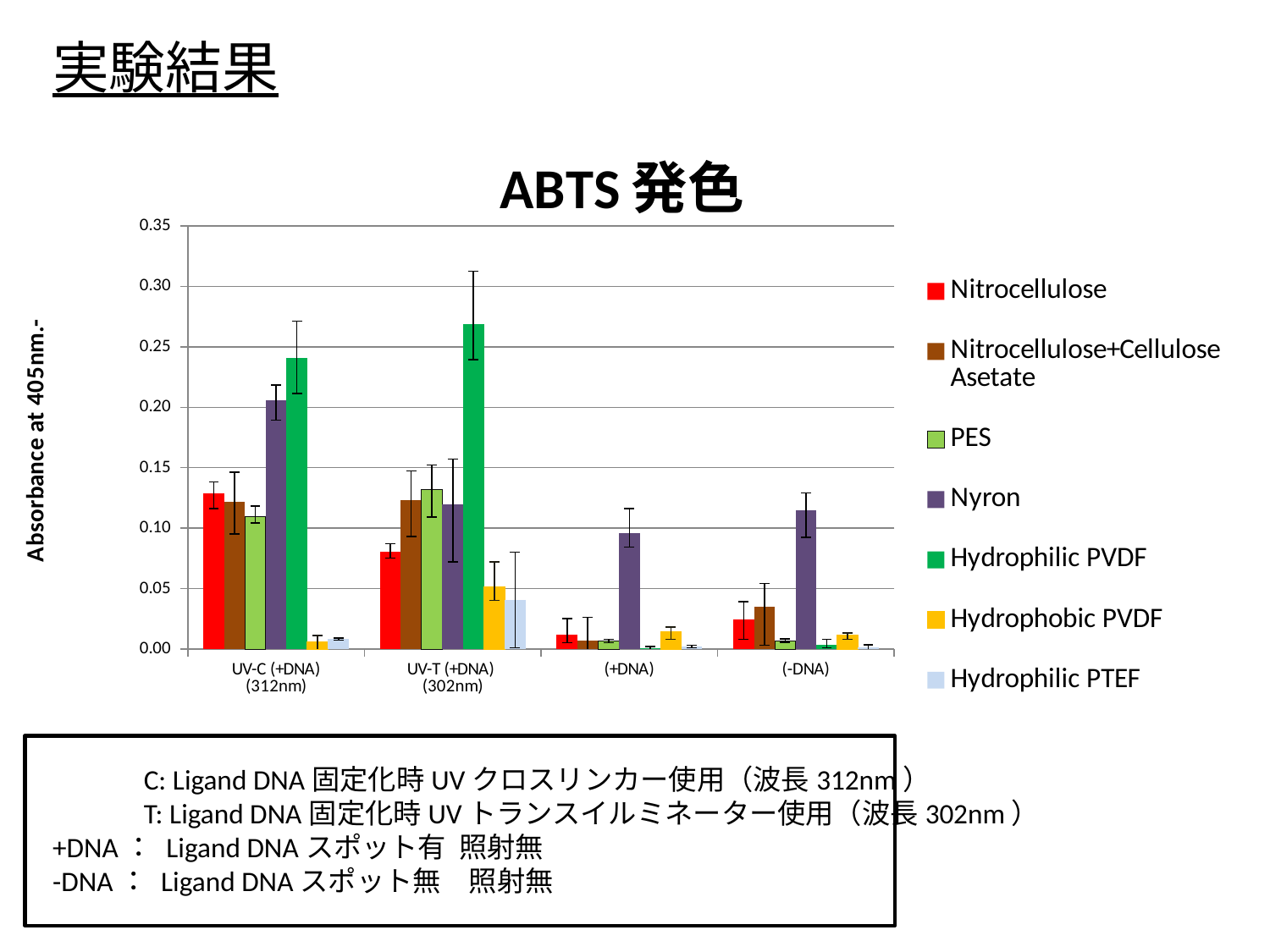
What kind of chart is shown on the slide? bar chart How many categories are shown on the x axis? 4 Is the value for Hydrophobic PVDF in the UV-T (+DNA) (302nm) category greater or less than 0.10? less Which is larger: the Hydrophilic PVDF value in UV-T (+DNA) (302nm) or in UV-C (+DNA) (312nm)? UV-T (+DNA) (302nm) Is the value for Hydrophilic PVDF in the UV-T (+DNA) (302nm) category greater or less than 0.25? greater Which series has the highest bar in the UV-T (+DNA) (302nm) category? Hydrophilic PVDF Which is larger: the Nitrocellulose value in UV-C (+DNA) (312nm) or in UV-T (+DNA) (302nm)? UV-C (+DNA) (312nm) How many series does the legend list? 7 What is the label of the y axis? Absorbance at 405nm.- Which series has the highest bar in the UV-C (+DNA) (312nm) category? Hydrophilic PVDF Which series has the highest bar in the (-DNA) category? Nyron Is the value for Nyron in the UV-C (+DNA) (312nm) category greater or less than 0.15? greater